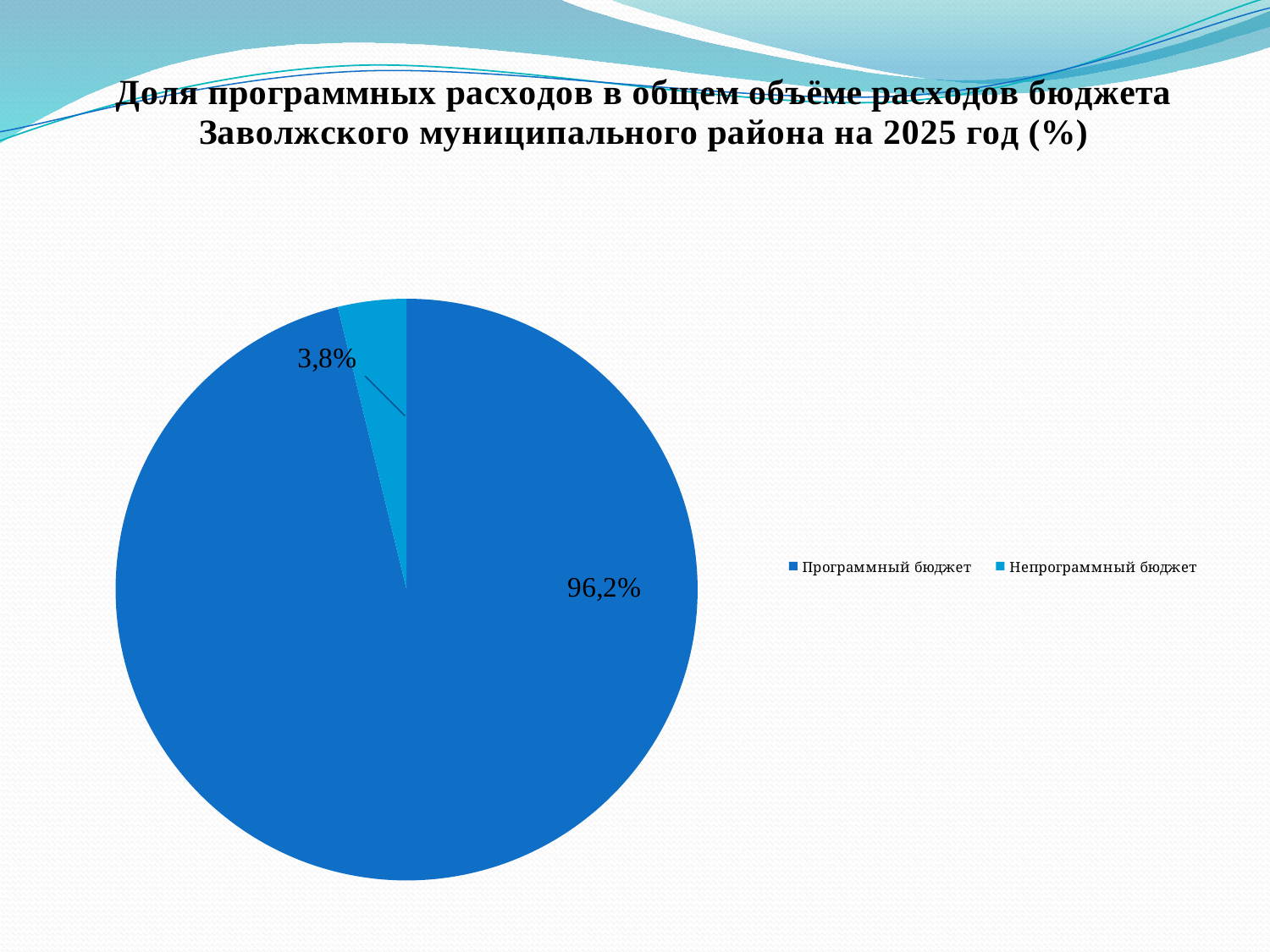
Which year does the chart title refer to? 2025 What is the difference between the shares of Программный бюджет and Непрограммный бюджет? 92,4% How many entries does the legend list? 2 What is the value for Непрограммный бюджет? 3,8% What kind of chart is shown on the slide? pie chart What is the value for Программный бюджет? 96,2% What share of the pie does Непрограммный бюджет take? 3,8% How many slices does the pie chart have? 2 Which category has the smallest share of the pie? Непрограммный бюджет What is the title of the chart? Доля программных расходов в общем объёме расходов бюджета Заволжского муниципального района на 2025 год (%) Which category has the largest share of the pie? Программный бюджет Which is larger: Программный бюджет or Непрограммный бюджет? Программный бюджет